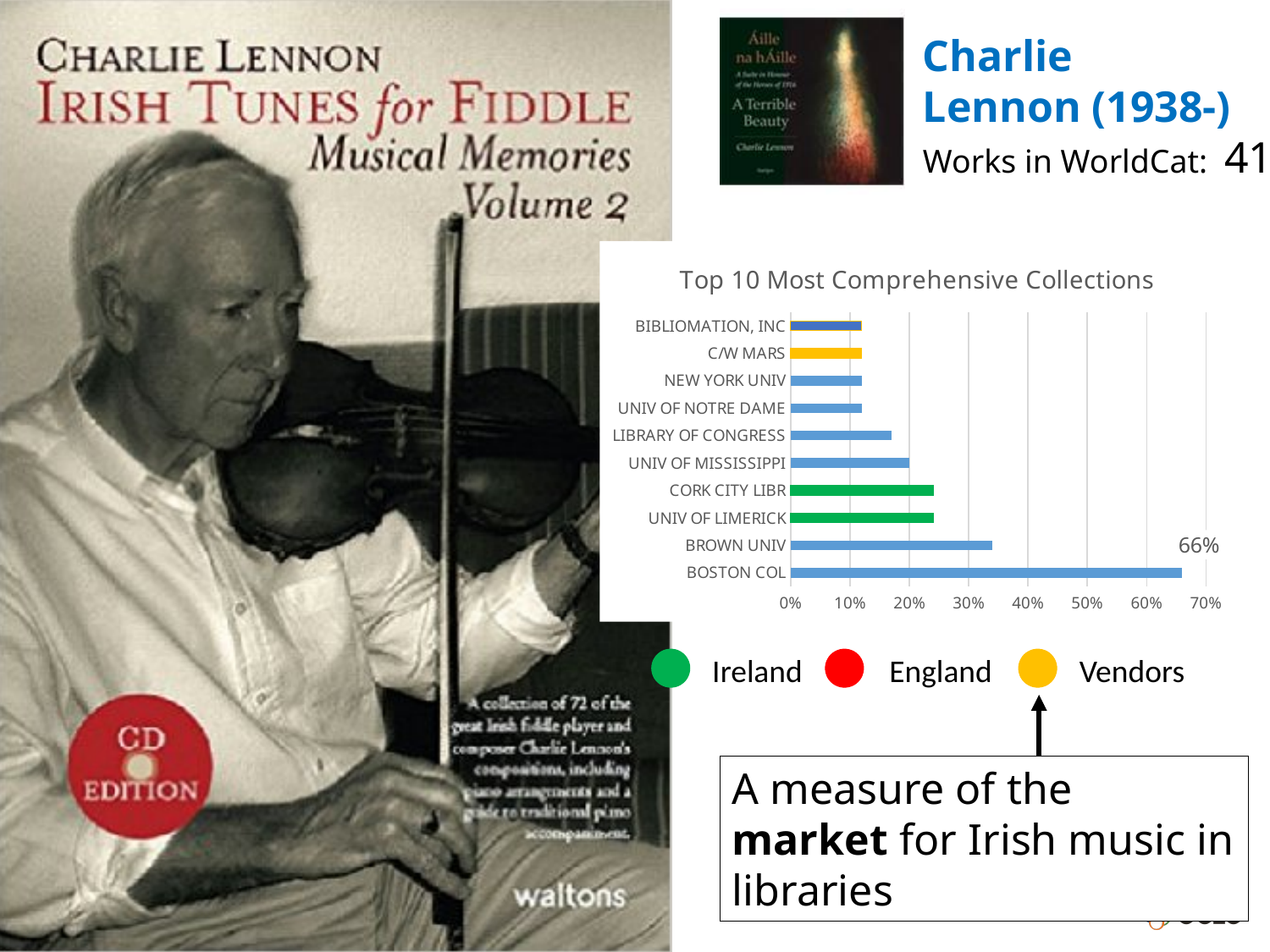
Which is larger, the value for BOSTON COL or the value for BROWN UNIV? BOSTON COL Which category's bar is coloured yellow in the Top 10 Most Comprehensive Collections chart? C/W MARS Which category has the highest value in the Top 10 Most Comprehensive Collections chart? BOSTON COL What is the value for BOSTON COL in the Top 10 Most Comprehensive Collections chart? 66% Which is larger, the value for BROWN UNIV or the value for LIBRARY OF CONGRESS? BROWN UNIV How many categories are shown in the Top 10 Most Comprehensive Collections chart? 10 Is the value for LIBRARY OF CONGRESS greater or less than 20%? less Is the value for CORK CITY LIBR greater or less than 20%? greater Is the value for BIBLIOMATION, INC greater or less than 20%? less What is the title of the bar chart on the slide? Top 10 Most Comprehensive Collections What kind of chart is the Top 10 Most Comprehensive Collections chart? bar chart